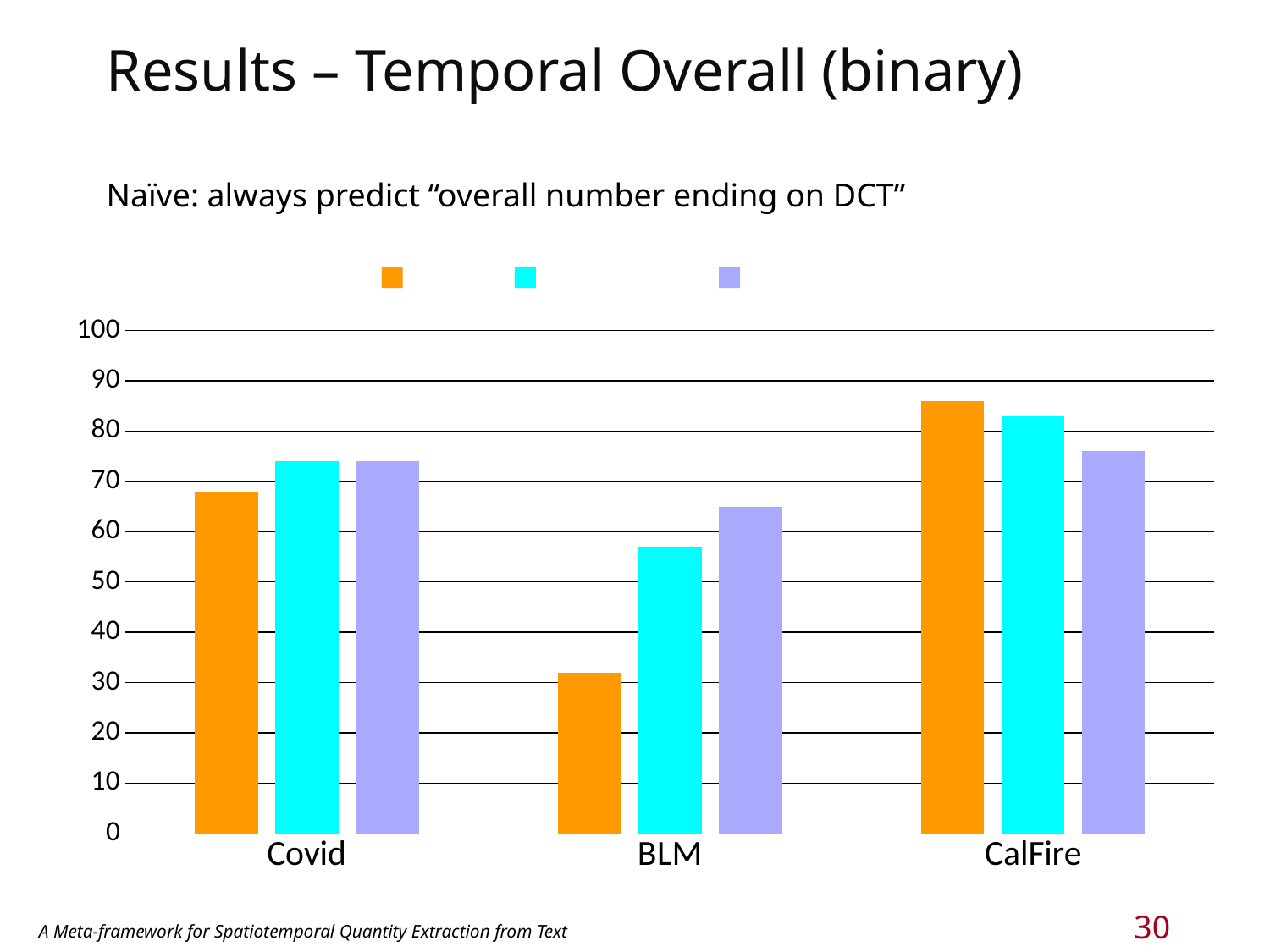
Which category has the highest orange bar? CalFire Is the value of the orange bar for CalFire greater or less than 80? greater Which category has the lowest orange bar? BLM How many categories are shown on the x axis of the chart? 3 For BLM, which bar is larger: the orange bar or the lavender bar? lavender Is the value of the cyan bar for BLM greater or less than 50? greater How many series does the chart's legend list? 3 Is the value of the orange bar for BLM greater or less than 40? less Which category has the lowest cyan bar? BLM What kind of chart is shown on the slide? bar chart For CalFire, which bar is larger: the orange bar or the lavender bar? orange